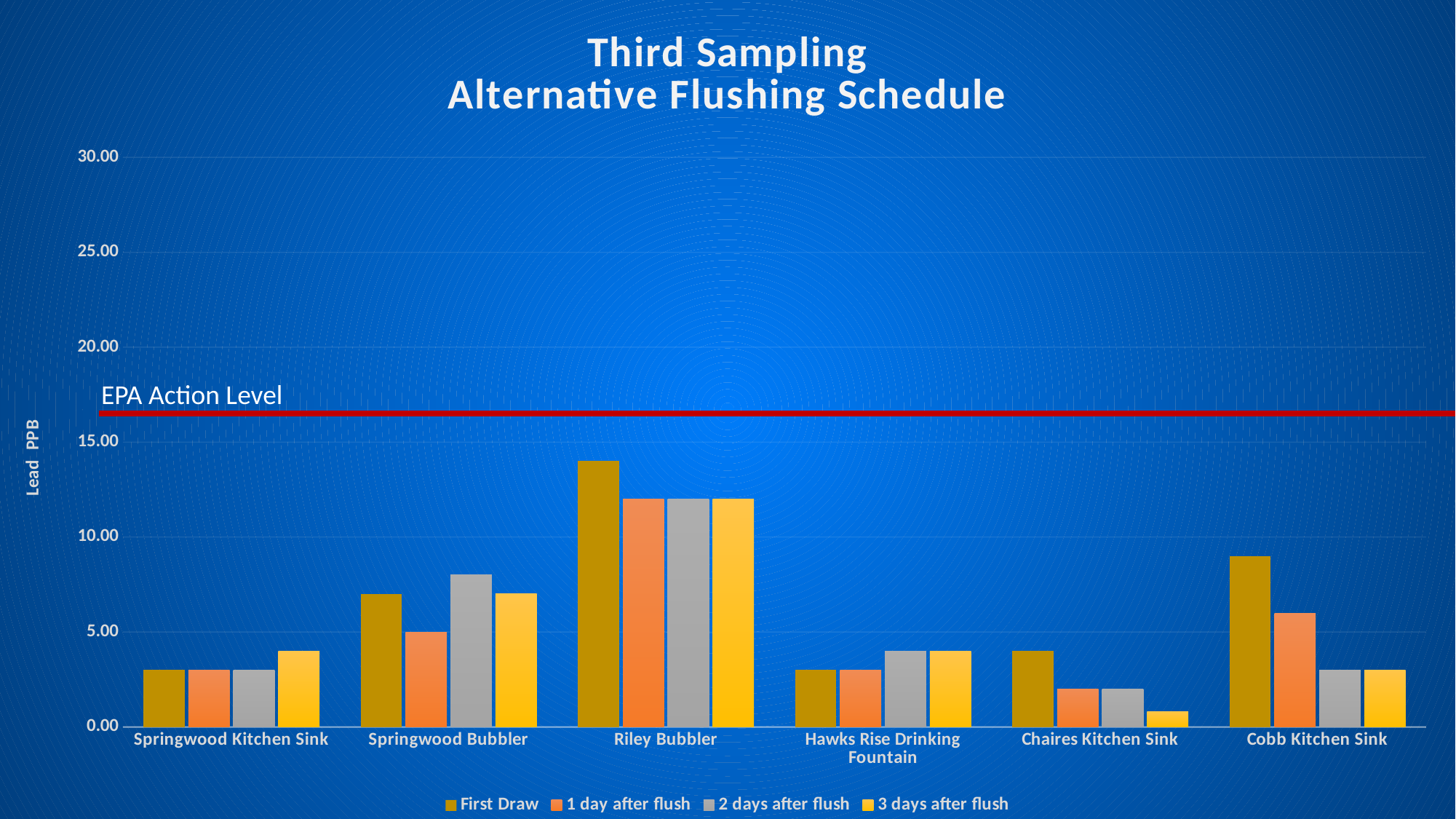
Which location has the lowest value for 3 days after flush? Chaires Kitchen Sink How many series does the legend list? 4 How many sampling locations are shown on the x axis? 6 Which location has the highest First Draw value? Riley Bubbler What kind of chart is shown on the slide? bar chart Is the First Draw value for Riley Bubbler greater or less than 15.00? less Is the First Draw value for Riley Bubbler greater or less than 10.00? greater What is the label on the y axis? Lead PPB Which has the larger First Draw value, Springwood Bubbler or Springwood Kitchen Sink? Springwood Bubbler For Cobb Kitchen Sink, which is larger, the First Draw value or the 1 day after flush value? First Draw What does the red horizontal line on the chart represent? EPA Action Level Is the First Draw value for Cobb Kitchen Sink greater or less than 5.00? greater